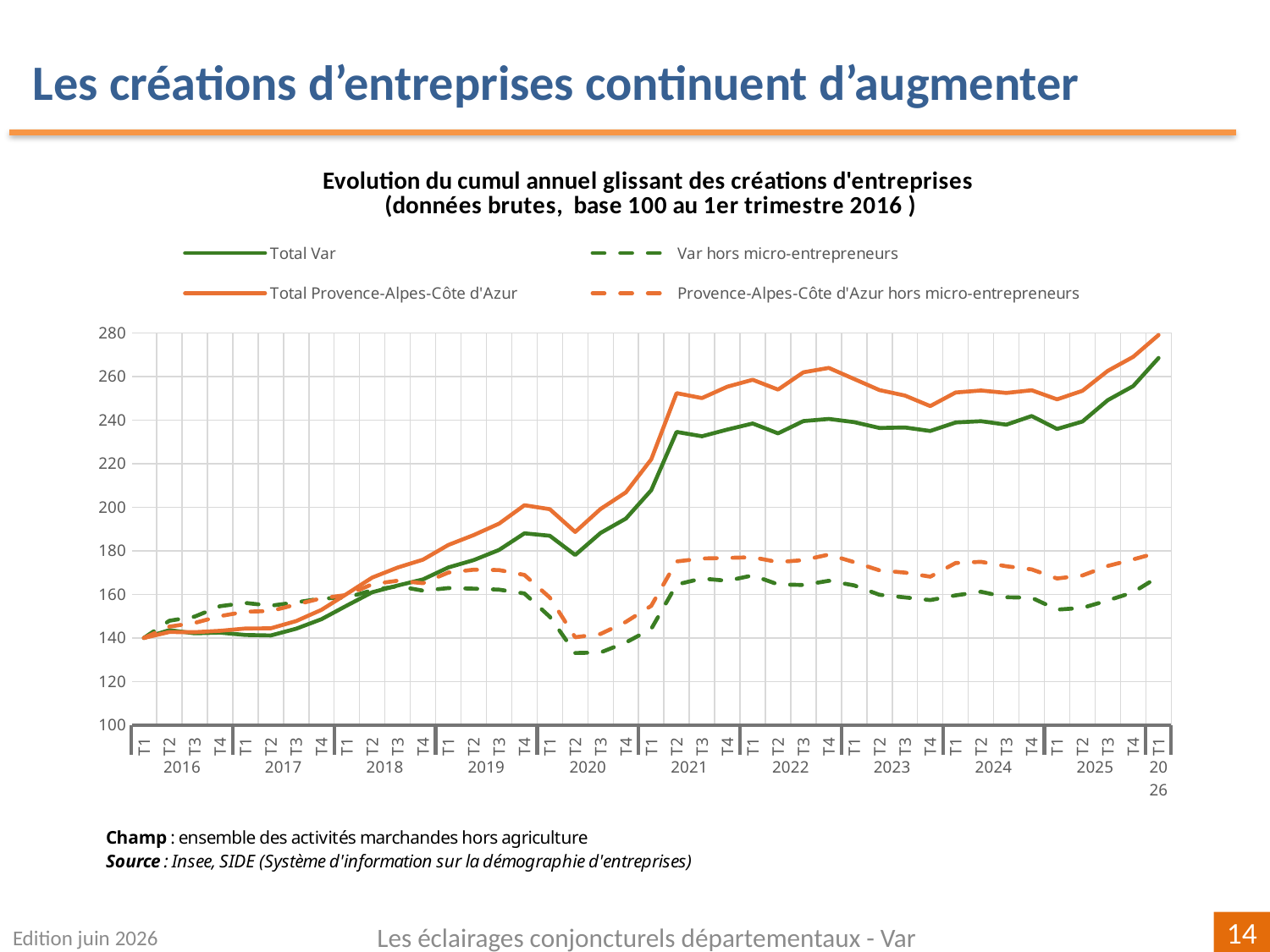
At T1 2026, which is higher: Total Var or Total Provence-Alpes-Côte d'Azur? Total Provence-Alpes-Côte d'Azur Is the value for Total Provence-Alpes-Côte d'Azur at T1 2026 greater or less than 260? greater What kind of chart is shown on the slide? line chart How many series does the legend list? 4 Is the value for Var hors micro-entrepreneurs at T2 2020 greater or less than 140? less What is the title of the chart? Evolution du cumul annuel glissant des créations d'entreprises (données brutes, base 100 au 1er trimestre 2016 ) How many years are labelled along the x axis? 11 Is the value for Total Provence-Alpes-Côte d'Azur at T2 2021 greater or less than 240? greater Overall, does the Total Var series rise or fall from T1 2016 to T1 2026? rise At T2 2020, which is higher: Var hors micro-entrepreneurs or Provence-Alpes-Côte d'Azur hors micro-entrepreneurs? Provence-Alpes-Côte d'Azur hors micro-entrepreneurs Which two series are drawn with dashed lines? Var hors micro-entrepreneurs and Provence-Alpes-Côte d'Azur hors micro-entrepreneurs